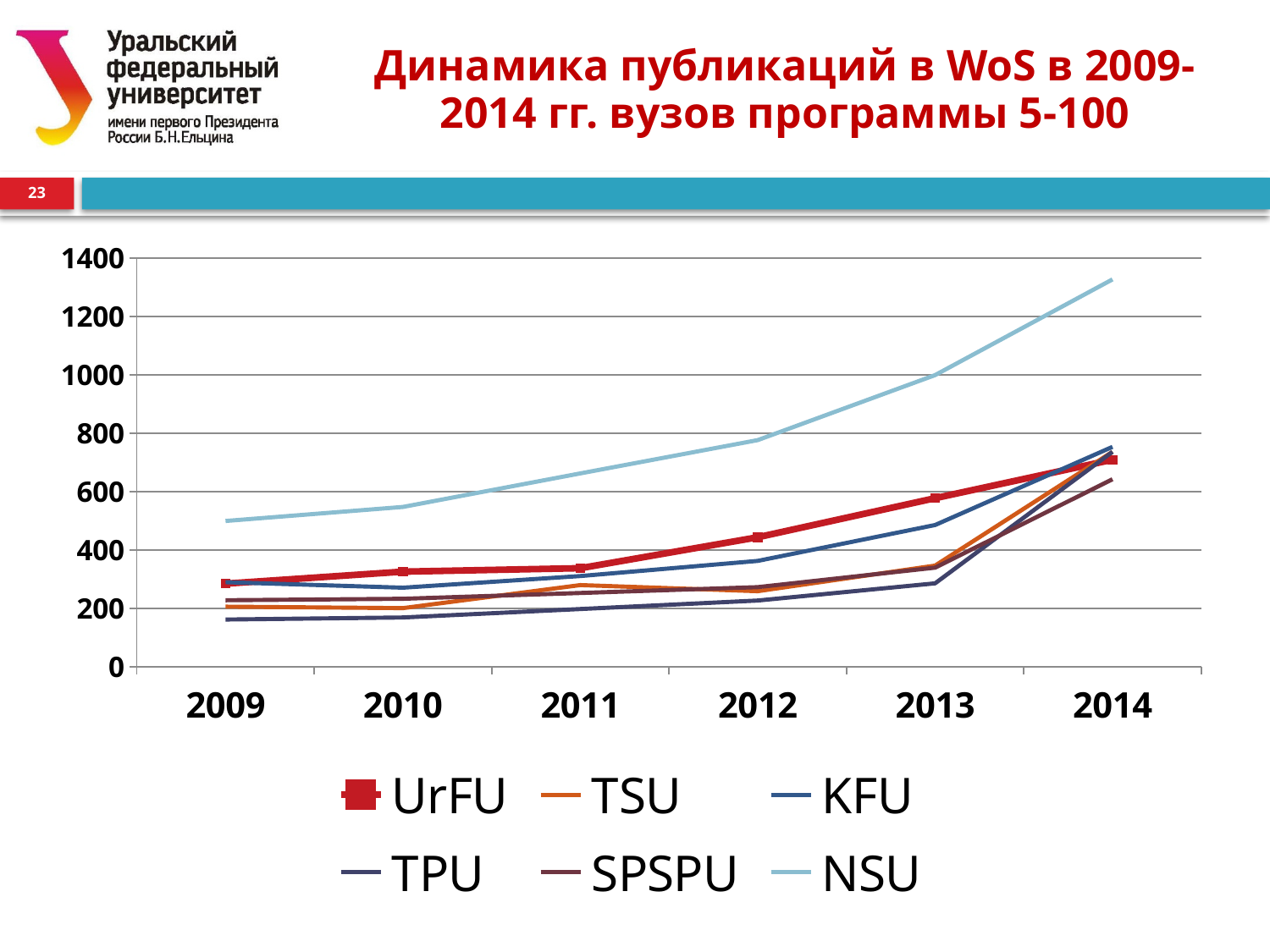
How many years are shown on the x axis? 6 How many series does the legend list? 6 Is the value for TPU in 2009 greater or less than 200? less Which university has the lowest number of publications in 2009? TPU Is the value for UrFU in 2013 greater or less than 400? greater Does the NSU line rise or fall from 2009 to 2014? rise Which university has the lowest number of publications in 2014? SPSPU What kind of chart is shown on the slide? line chart Which series is drawn with the thick red line? UrFU Which university has the highest number of publications in 2014? NSU Which is larger in 2013, the value for KFU or the value for TPU? KFU Is the value for NSU in 2014 greater or less than 1200? greater